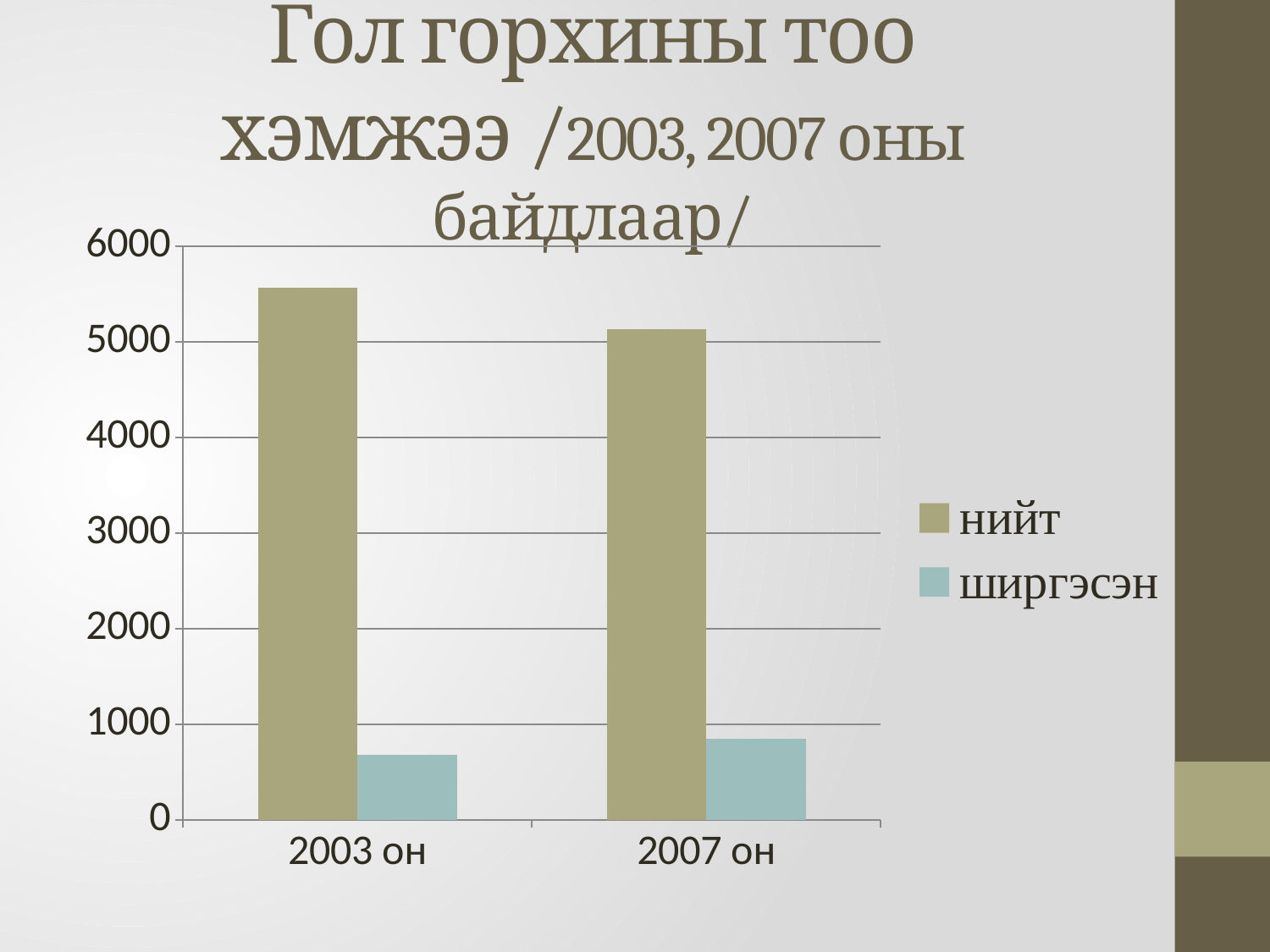
Is the value for ширгэсэн in 2007 он greater or less than 1000? less How many categories are shown on the x axis? 2 Is the value for ширгэсэн in 2003 он greater or less than 1000? less What kind of chart is shown on the slide? bar chart Does the value for нийт rise or fall from 2003 он to 2007 он? fall Which series is shown in the light blue colour? ширгэсэн Is the value for нийт in 2003 он greater or less than 5000? greater Does the value for ширгэсэн rise or fall from 2003 он to 2007 он? rise How many series does the legend list? 2 Which year has the higher value for ширгэсэн, 2003 он or 2007 он? 2007 он Which year has the higher value for нийт, 2003 он or 2007 он? 2003 он